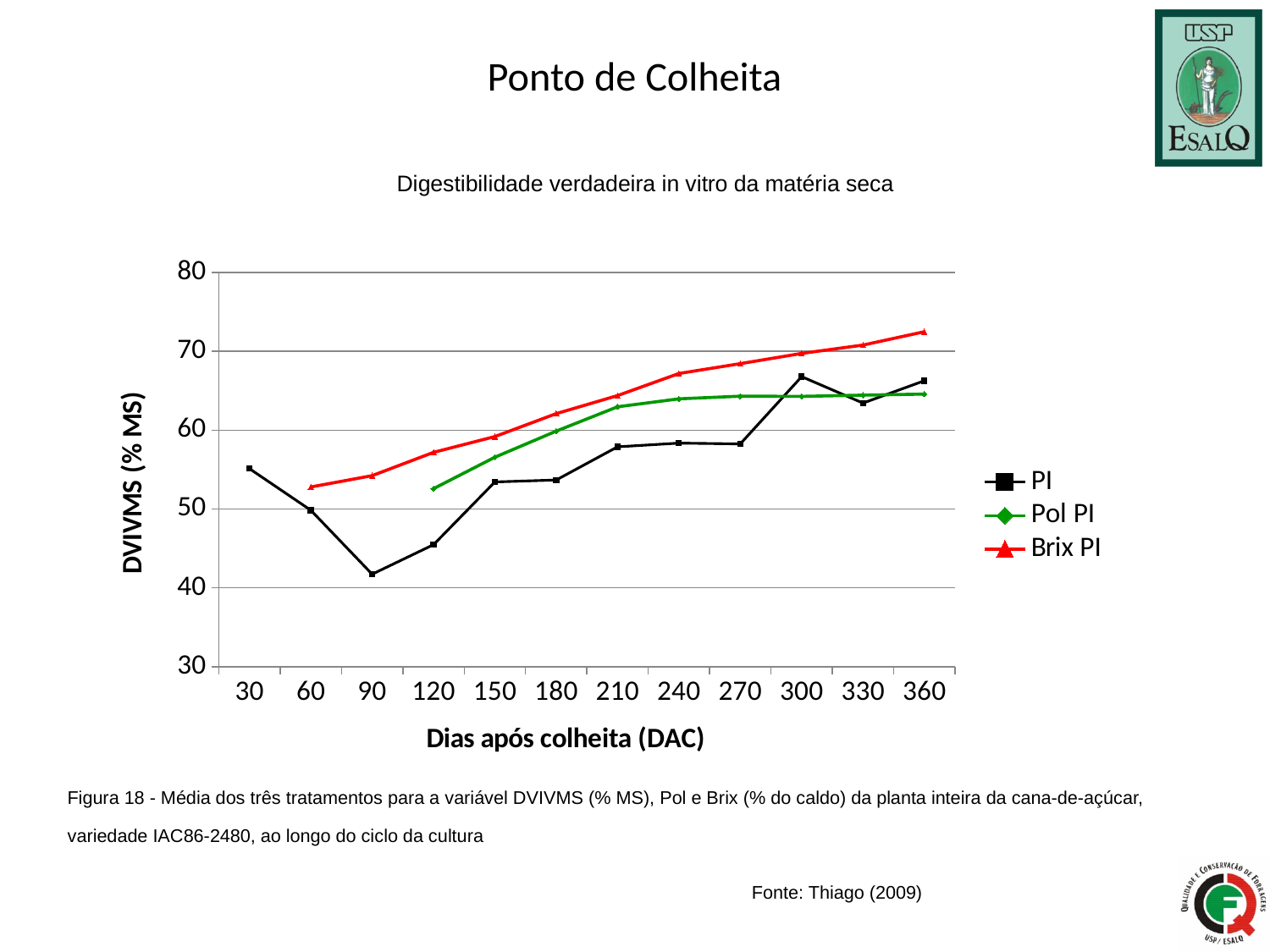
How many series does the legend list? 3 At which DAC value does the PI series reach its lowest point? 90 Is the value for Pol PI at 120 DAC greater or less than 60? less Is the value for PI at 90 DAC greater or less than 50? less At which DAC value does the Brix PI series reach its highest point? 360 Does the Brix PI series rise or fall along the x axis? rise Is the value for Brix PI at 360 DAC greater or less than 70? greater At 360 DAC, which series has the larger value, Brix PI or PI? Brix PI How many DAC categories are shown on the x axis? 12 What is the title of the y axis? DVIVMS (% MS) At 300 DAC, which series has the larger value, PI or Pol PI? PI What kind of chart is shown on the slide? line chart